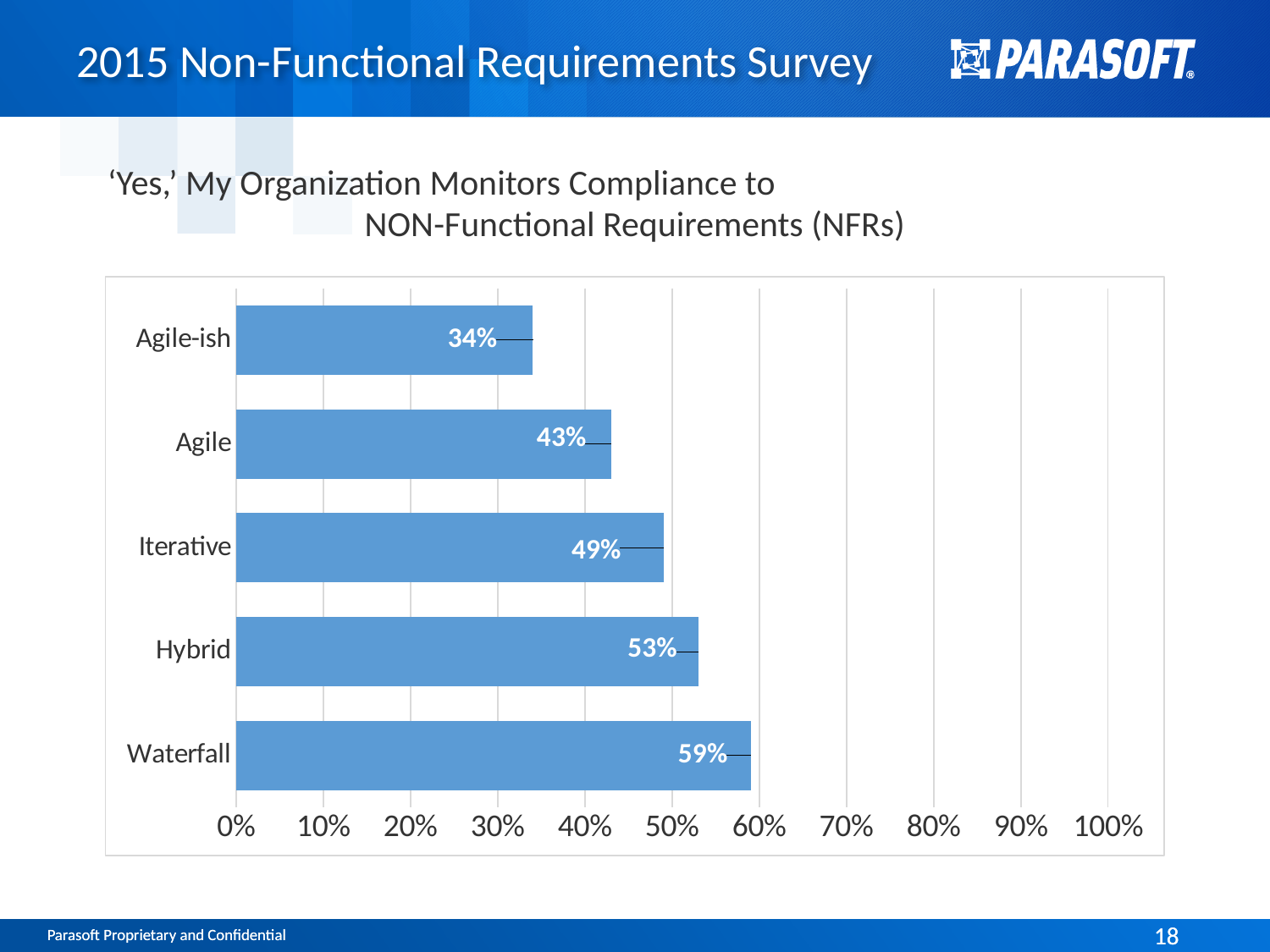
What is the difference between the values for Hybrid and Agile? 10% How many categories are shown in the chart? 5 Is the value for Hybrid greater or less than 50%? greater Which category has the highest value? Waterfall What percentage is shown for Iterative? 49% What percentage is shown for Waterfall? 59% What is the difference between the values for Waterfall and Agile-ish? 25% What kind of chart is shown on the slide? Bar chart What percentage is shown for Agile-ish? 34% Which is larger, the value for Iterative or the value for Agile? Iterative What is the maximum value shown on the horizontal axis? 100% Which category has the lowest value? Agile-ish